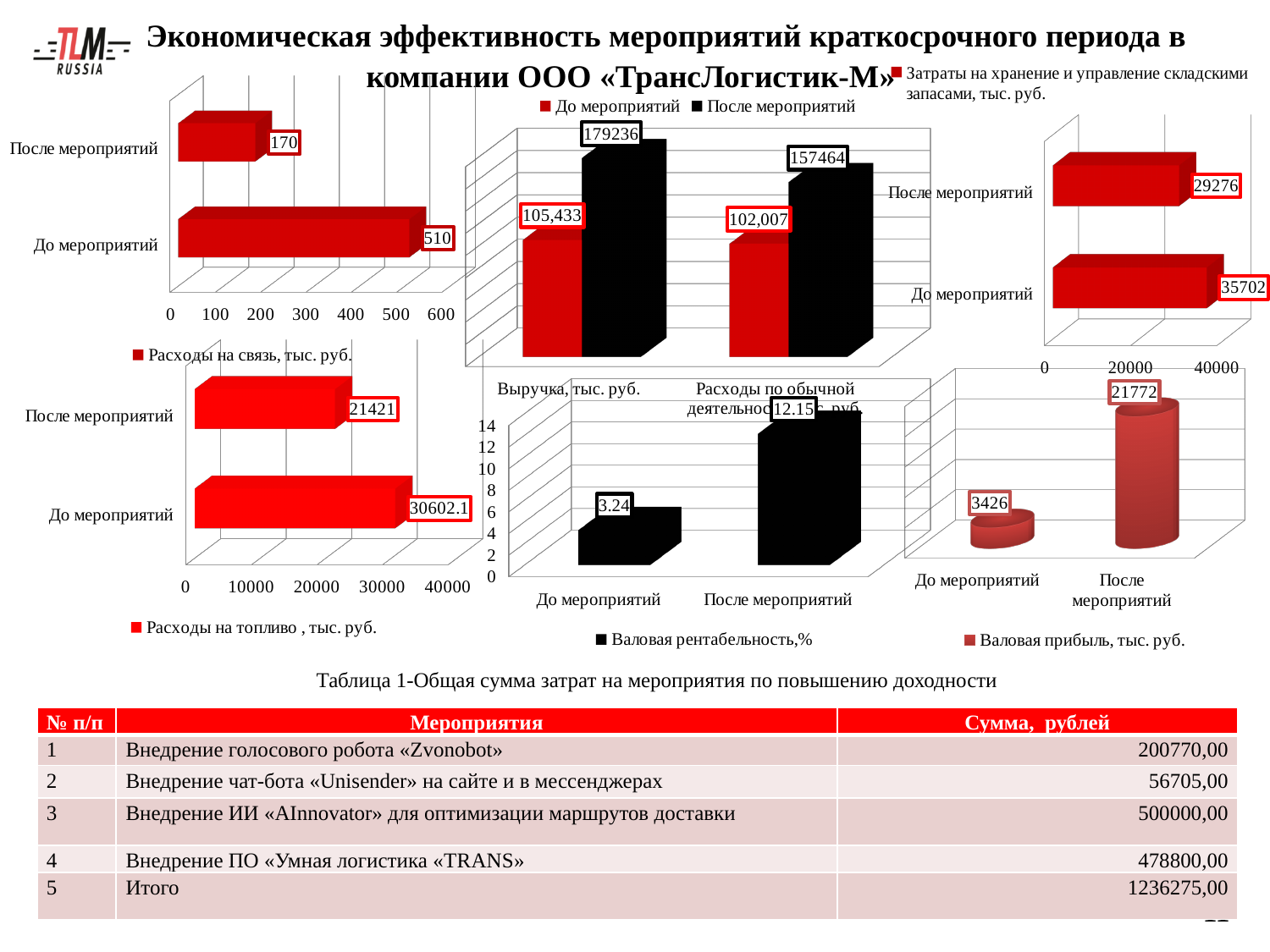
In the chart with the legend "До мероприятий" and "После мероприятий" (top centre), what is the value of "Расходы по обычной деятельности, тыс. руб." for "До мероприятий"? 102,007 In the chart titled "Расходы на топливо , тыс. руб.", which category has the lower value? После мероприятий In the chart titled "Расходы на связь, тыс. руб.", what is the value for "До мероприятий"? 510 In the chart titled "Затраты на хранение и управление складскими запасами, тыс. руб.", what is the value for "До мероприятий"? 35702 In the chart titled "Валовая прибыль, тыс. руб.", which category has the higher value? После мероприятий In the chart with the legend "До мероприятий" and "После мероприятий" (top centre), what is the value of "Выручка, тыс. руб." for "После мероприятий"? 179236 In the chart titled "Валовая прибыль, тыс. руб.", what is the value for "До мероприятий"? 3426 In the chart with the legend "До мероприятий" and "После мероприятий" (top centre), how many series does the legend list? 2 In the chart titled "Расходы на связь, тыс. руб.", what is the value for "После мероприятий"? 170 In the chart titled "Валовая рентабельность,%", what is the value for "После мероприятий"? 12.15 In the chart titled "Затраты на хранение и управление складскими запасами, тыс. руб.", what is the difference between "До мероприятий" and "После мероприятий"? 6426 In the chart titled "Расходы на топливо , тыс. руб.", what is the value for "До мероприятий"? 30602.1